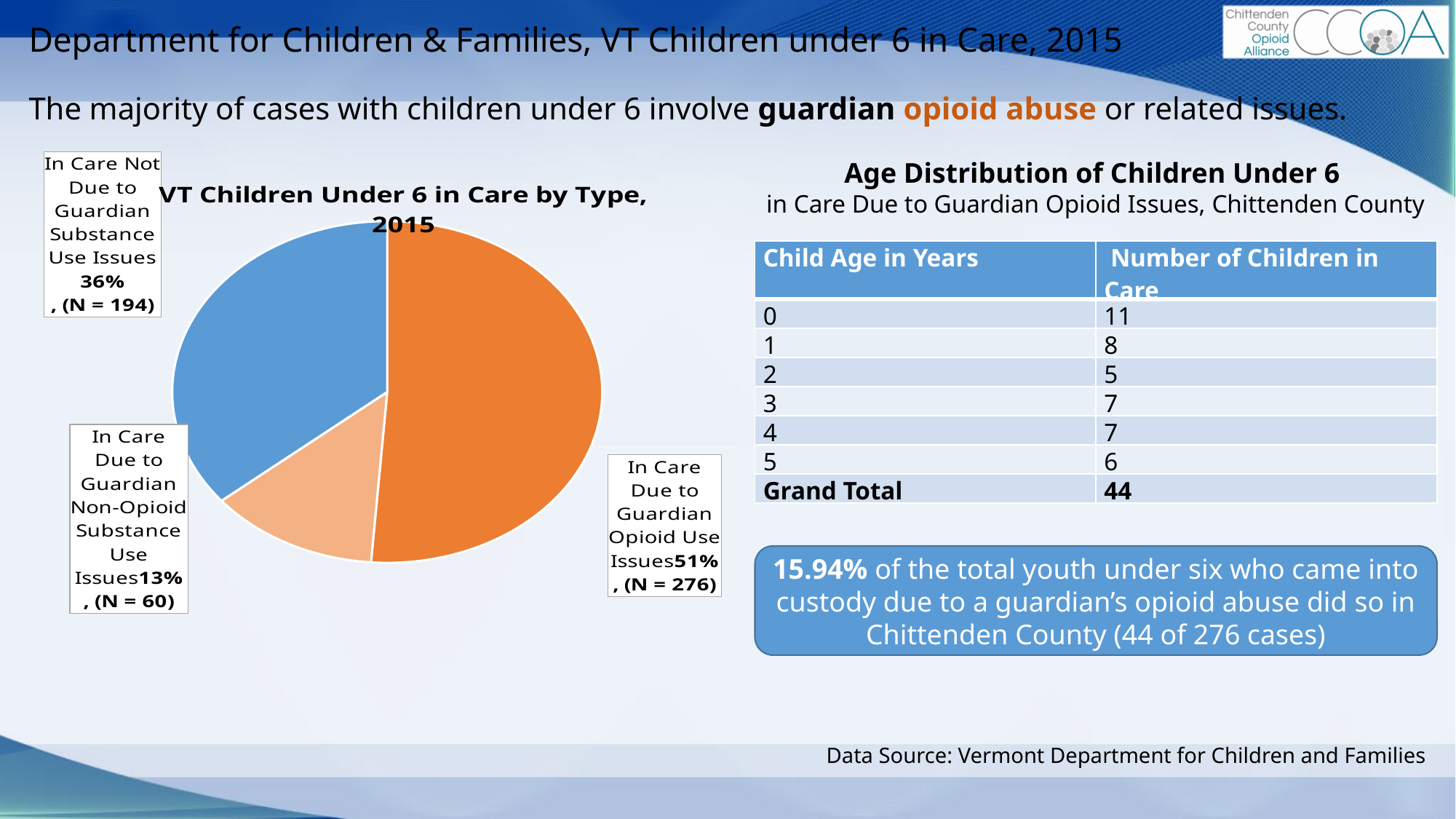
What kind of chart is "VT Children Under 6 in Care by Type, 2015"? pie chart In the pie chart, which slice is larger: In Care Not Due to Guardian Substance Use Issues or In Care Due to Guardian Non-Opioid Substance Use Issues? In Care Not Due to Guardian Substance Use Issues Which category in the pie chart has the largest share? In Care Due to Guardian Opioid Use Issues Which category in the pie chart has the smallest share? In Care Due to Guardian Non-Opioid Substance Use Issues How many slices does the pie chart "VT Children Under 6 in Care by Type, 2015" have? 3 In the pie chart, what is the N value for children in care due to guardian opioid use issues? 276 In the pie chart, what share of children under 6 are in care due to guardian opioid use issues? 51% In the pie chart, what share of children under 6 are in care due to guardian non-opioid substance use issues? 13% In the pie chart, what share of children under 6 are in care not due to guardian substance use issues? 36% In the pie chart, what is the N value for children in care not due to guardian substance use issues? 194 In the pie chart, what is the difference in percentage points between the opioid use issues slice and the non-opioid substance use issues slice? 38 In the pie chart, what is the N value for children in care due to guardian non-opioid substance use issues? 60